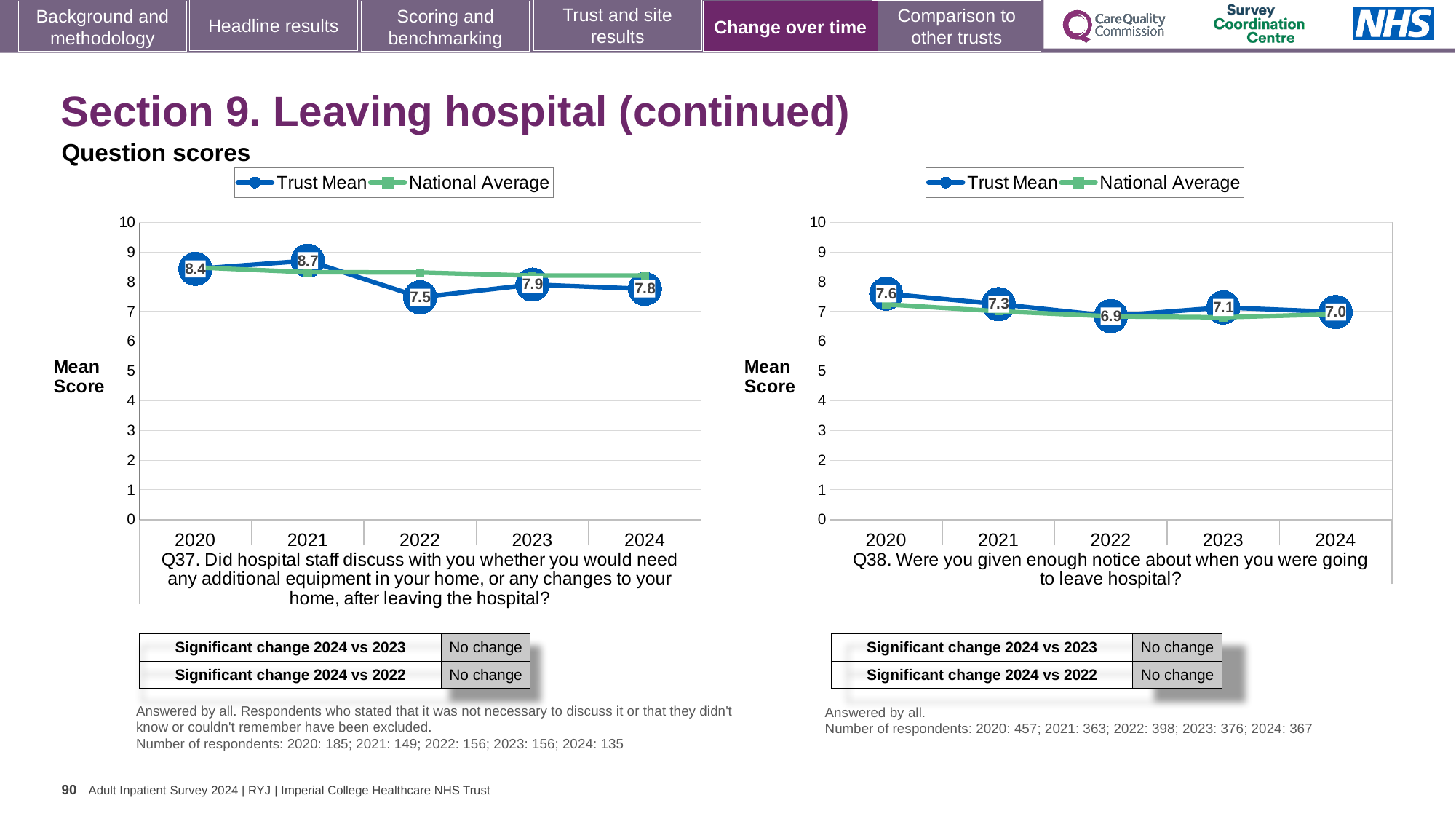
On the Q38 chart (right), what is the difference between the Trust Mean scores for 2020 and 2024? 0.6 On the Q37 chart (left), what is the Trust Mean score for 2021? 8.7 On the Q37 chart (left), what is the Trust Mean score for 2022? 7.5 On the Q38 chart (right), what is the Trust Mean score for 2020? 7.6 On the Q37 chart (left), which year has the highest Trust Mean score? 2021 On the Q37 chart (left), is the Trust Mean score higher in 2020 or in 2024? 2020 On the Q38 chart (right), is the National Average value for 2020 greater or less than 8? less On the Q37 chart (left), what is the difference between the Trust Mean scores for 2021 and 2022? 1.2 On the Q38 chart (right), which year has the lowest Trust Mean score? 2022 How many years are plotted on the x axis of the Q38 chart (right)? 5 How many series does the legend of the Q37 chart (left) list? 2 On the Q38 chart (right), what is the Trust Mean score for 2024? 7.0